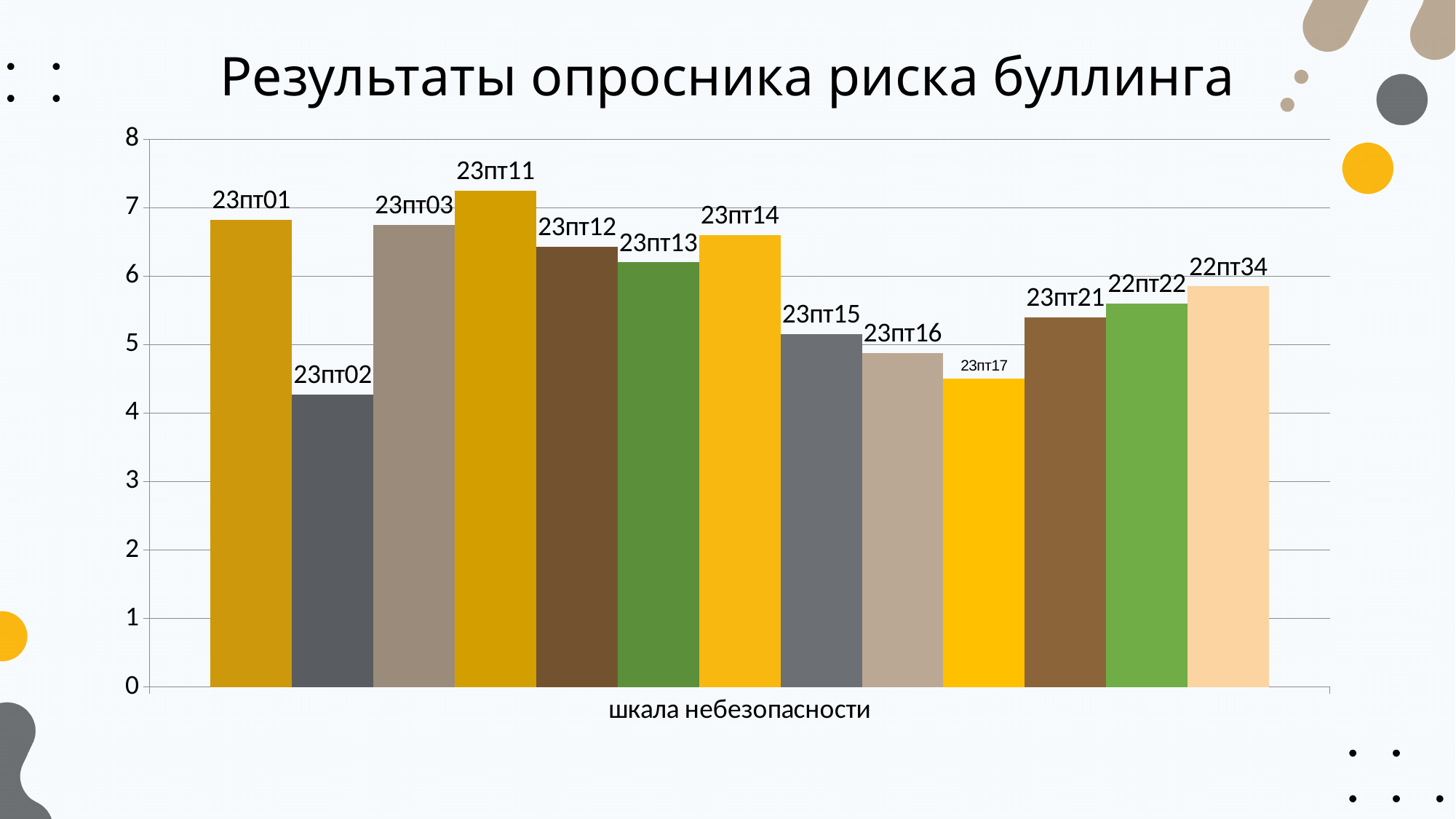
Which group has the highest bar in the chart? 23пт11 Is the value for 22пт34 greater or less than 6? less Is the value for 23пт02 greater or less than 5? less Which group has the lowest bar in the chart? 23пт02 What is the title of the chart? Результаты опросника риска буллинга Which has the larger value, 23пт14 or 23пт13? 23пт14 What is the label shown under the x axis of the chart? шкала небезопасности What type of chart is shown on the slide? bar chart Is the value for 23пт11 greater or less than 7? greater Which has the larger value, 23пт01 or 23пт02? 23пт01 How many bars are plotted in the chart? 13